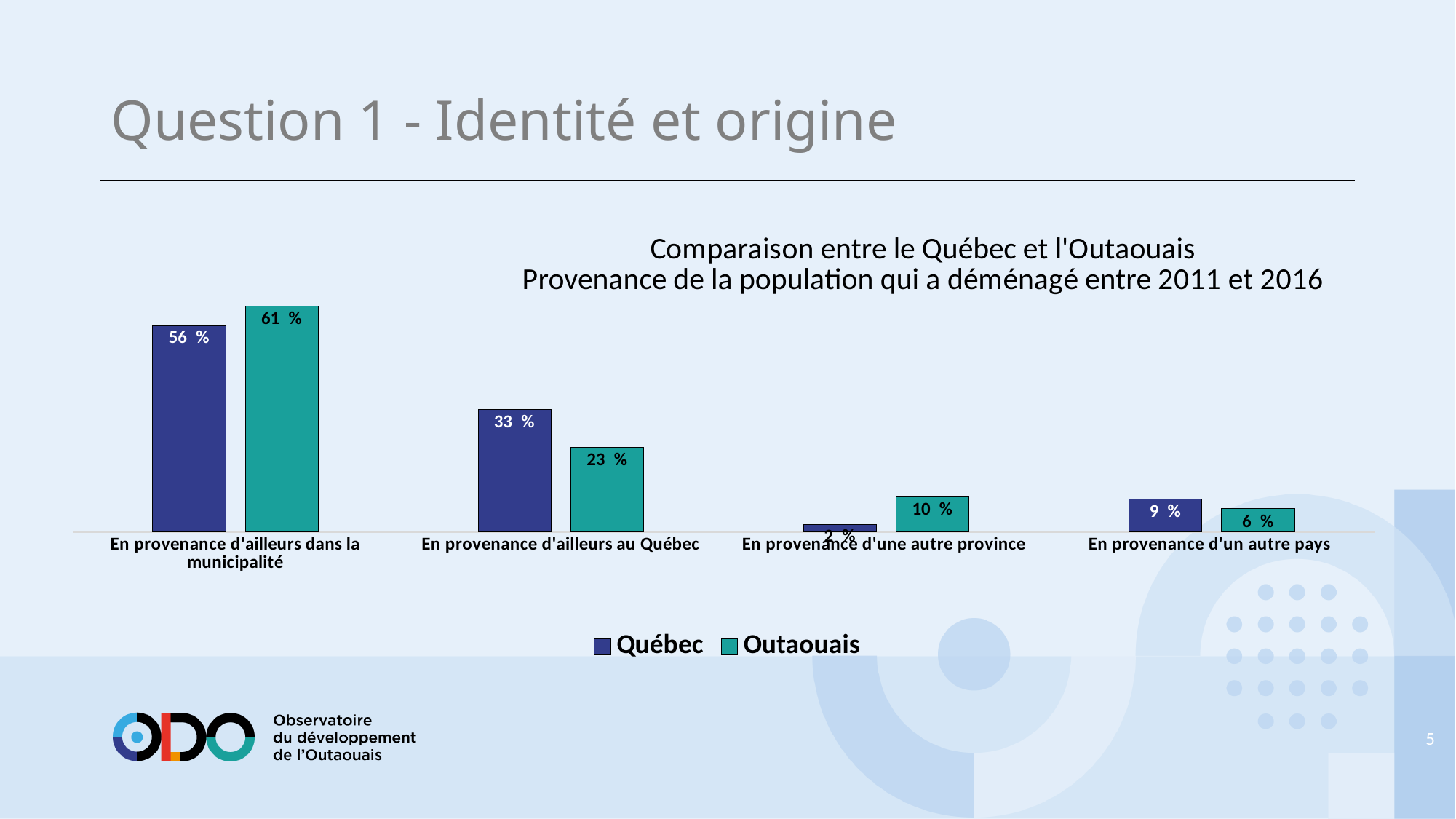
What is the Outaouais value for "En provenance d'une autre province"? 10 % How many categories are shown on the x axis? 4 What is the difference between the Outaouais and Québec values for "En provenance d'ailleurs dans la municipalité"? 5 % Which category has the lowest Québec value? En provenance d'une autre province What is the Québec value for "En provenance d'ailleurs dans la municipalité"? 56 % What is the Québec value for "En provenance d'un autre pays"? 9 % For "En provenance d'un autre pays", which series has the larger value, Québec or Outaouais? Québec What kind of chart is shown on the slide? Bar chart What is the Outaouais value for "En provenance d'ailleurs au Québec"? 23 % What is the difference between the Québec and Outaouais values for "En provenance d'ailleurs au Québec"? 10 % Which category has the highest Outaouais value? En provenance d'ailleurs dans la municipalité How many series does the legend list? 2